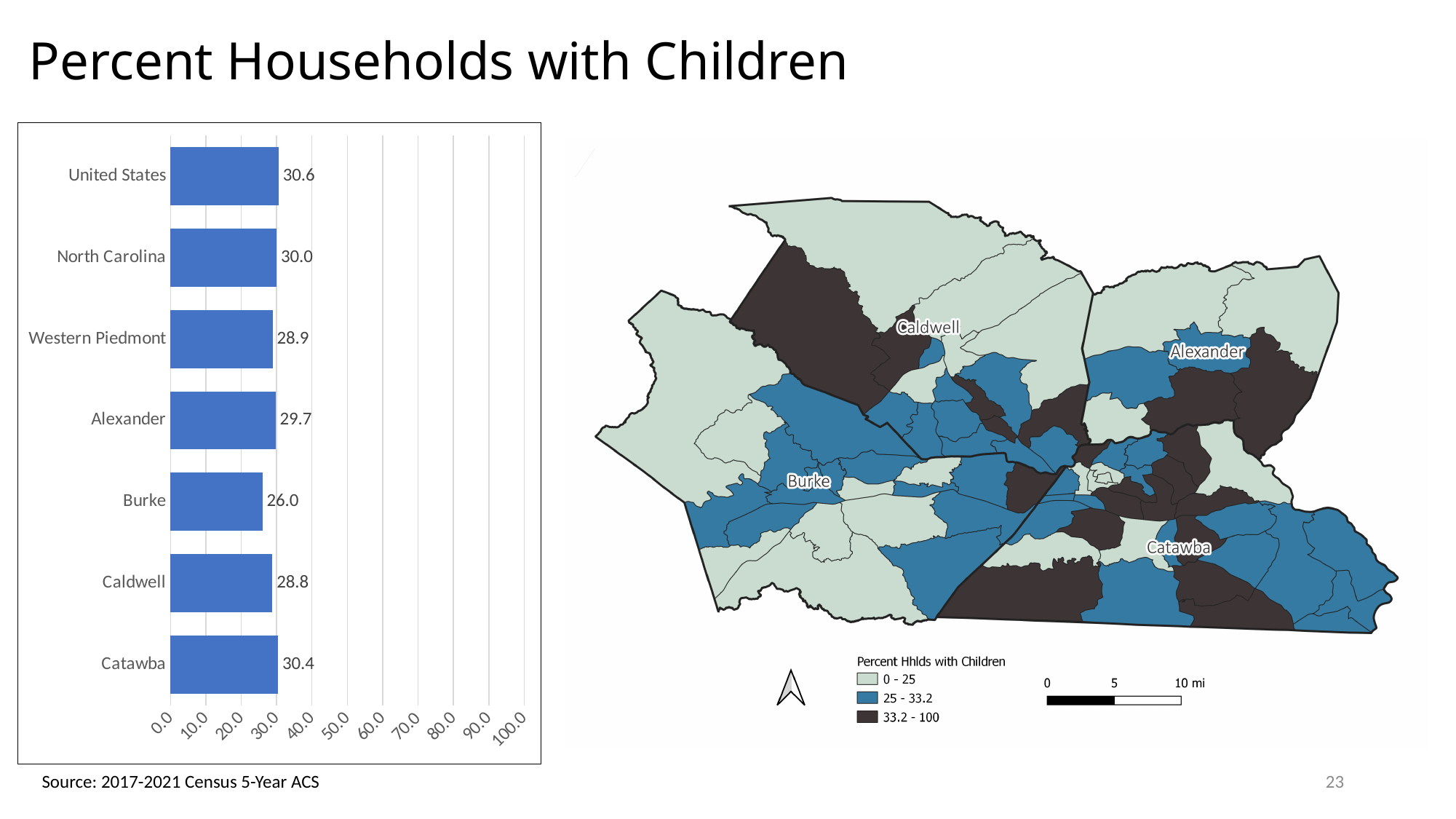
How many classes does the map legend 'Percent Hhlds with Children' list? 3 What kind of chart is on the left side of the slide? bar chart In the bar chart, which category has the highest value? United States In the bar chart, which is larger, the value for Alexander or the value for Caldwell? Alexander How many categories are shown in the bar chart? 7 In the bar chart, which category has the lowest value? Burke In the bar chart, what is the value for Burke? 26.0 In the bar chart, is the value for Burke greater or less than 30.0? less In the bar chart, what is the difference between the Catawba value and the Caldwell value? 1.6 In the bar chart, what is the value for North Carolina? 30.0 In the bar chart, what is the value for Western Piedmont? 28.9 In the bar chart, what is the difference between the United States value and the Burke value? 4.6